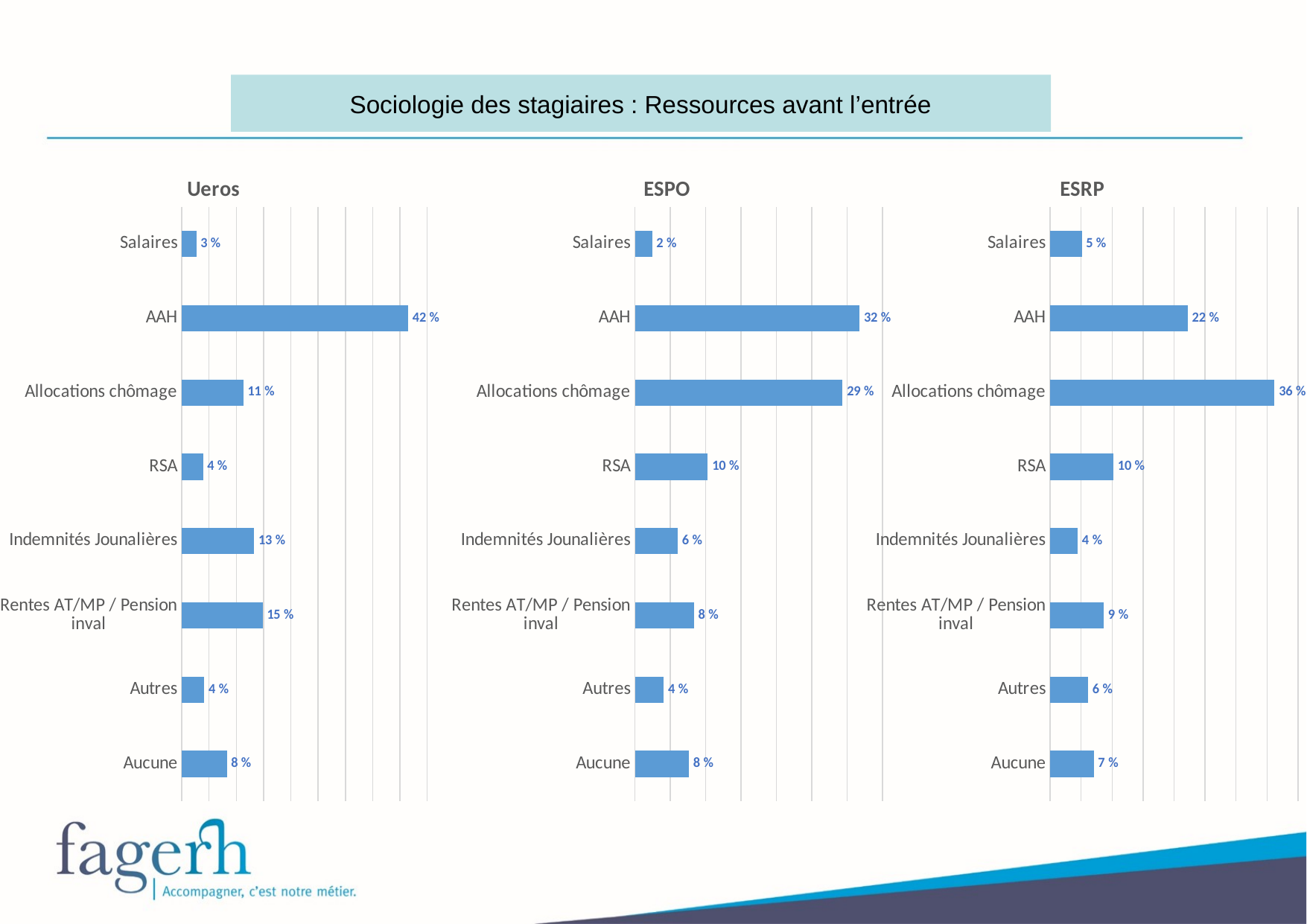
In the ESPO chart, which is larger, RSA or Indemnités Jounalières? RSA How many categories does the Ueros chart show? 8 In the ESRP chart, which category has the highest value? Allocations chômage In the Ueros chart, what is the difference between AAH and Allocations chômage? 31 % In the ESRP chart, what is the difference between Allocations chômage and AAH? 14 % In the Ueros chart, what is the value for AAH? 42 % In the ESPO chart, which category has the lowest value? Salaires What kind of chart is the ESPO chart? bar chart How many charts are on the slide? 3 In the ESPO chart, what is the value for Allocations chômage? 29 % In the ESRP chart, what is the value for Rentes AT/MP / Pension inval? 9 % What is the title of the chart on the right of the slide? ESRP